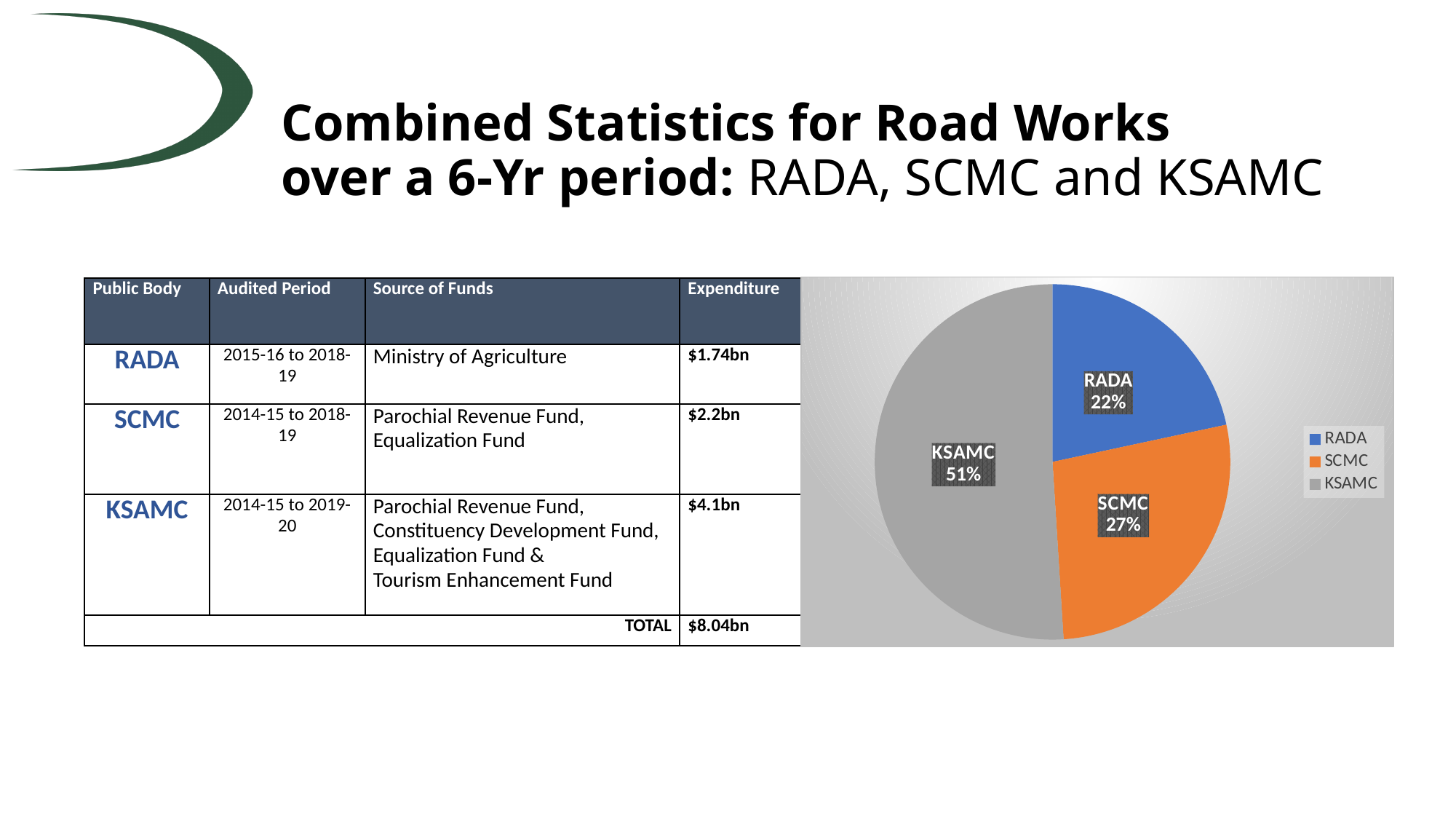
What share of the pie does SCMC represent? 27% What is the difference in percentage points between the KSAMC and SCMC slices? 24 Which public body has the largest slice of the pie? KSAMC What colour is the SCMC slice in the pie chart? orange What colour is the RADA slice in the pie chart? blue How many slices does the pie chart have? 3 What share of the pie does KSAMC represent? 51% What kind of chart is shown on the slide? pie chart Which public body has the smallest slice of the pie? RADA Which slice is larger, SCMC or RADA? SCMC How many entries does the legend list? 3 What share of the pie does RADA represent? 22%